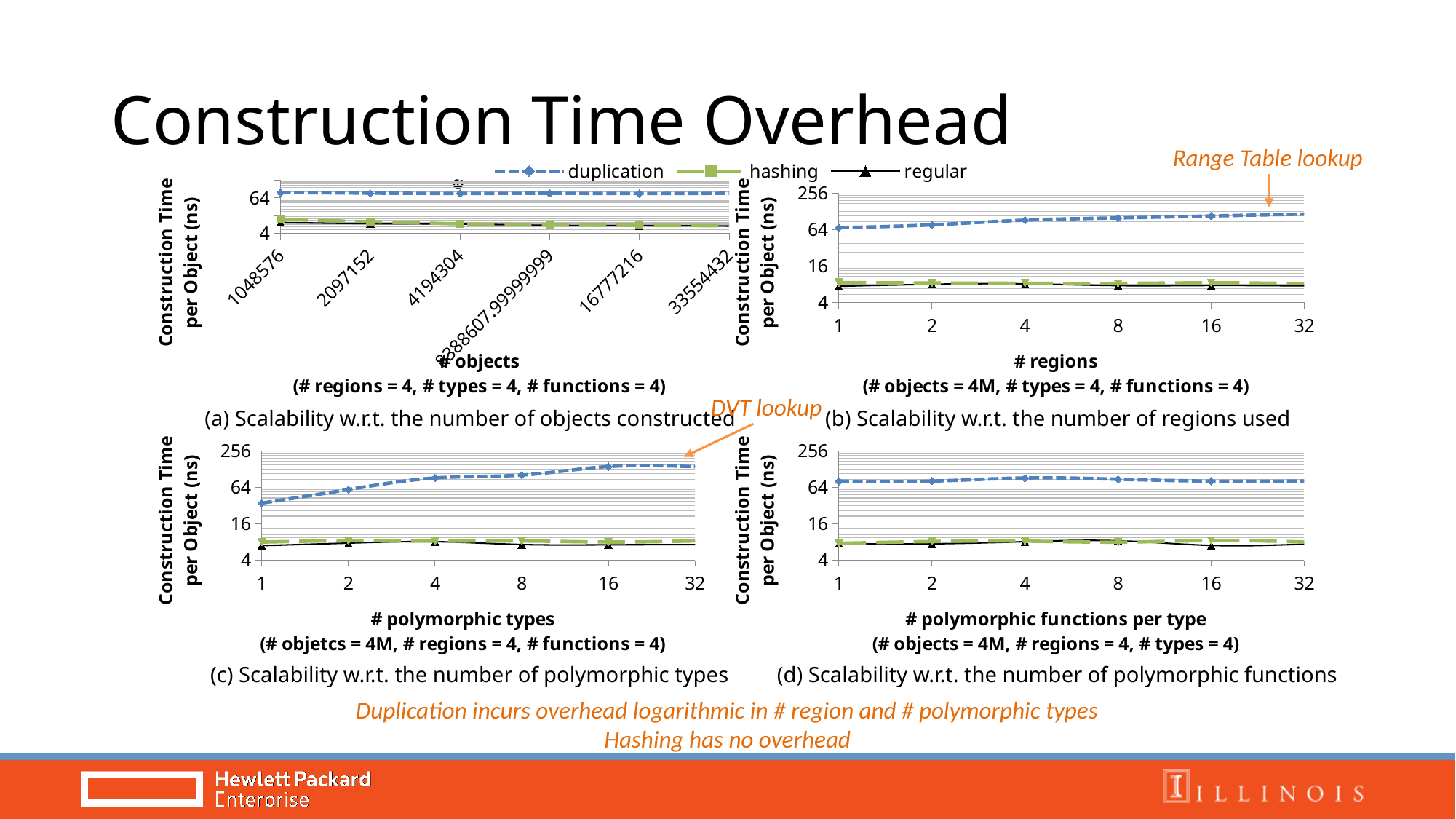
In chart (c), which series has the highest construction time per object across the x axis? duplication How many series does the shared legend at the top of the slide list? 3 In chart (c), is the duplication value at 1 polymorphic type greater or less than 64? less In chart (b), is the duplication value at 32 regions greater or less than 64? greater What are the three series named in the legend? duplication, hashing, regular In chart (d), 'Scalability w.r.t. the number of polymorphic functions', which is larger at 4 polymorphic functions per type: duplication or regular? duplication In chart (c), 'Scalability w.r.t. the number of polymorphic types', does the duplication series rise or fall as the number of polymorphic types increases? rise In chart (d), is the duplication value at 1 polymorphic function per type greater or less than 64? greater What kind of chart is chart (a), 'Scalability w.r.t. the number of objects constructed'? line chart What is the x-axis label of chart (d)? # polymorphic functions per type In chart (b), 'Scalability w.r.t. the number of regions used', how many x-axis values are plotted? 6